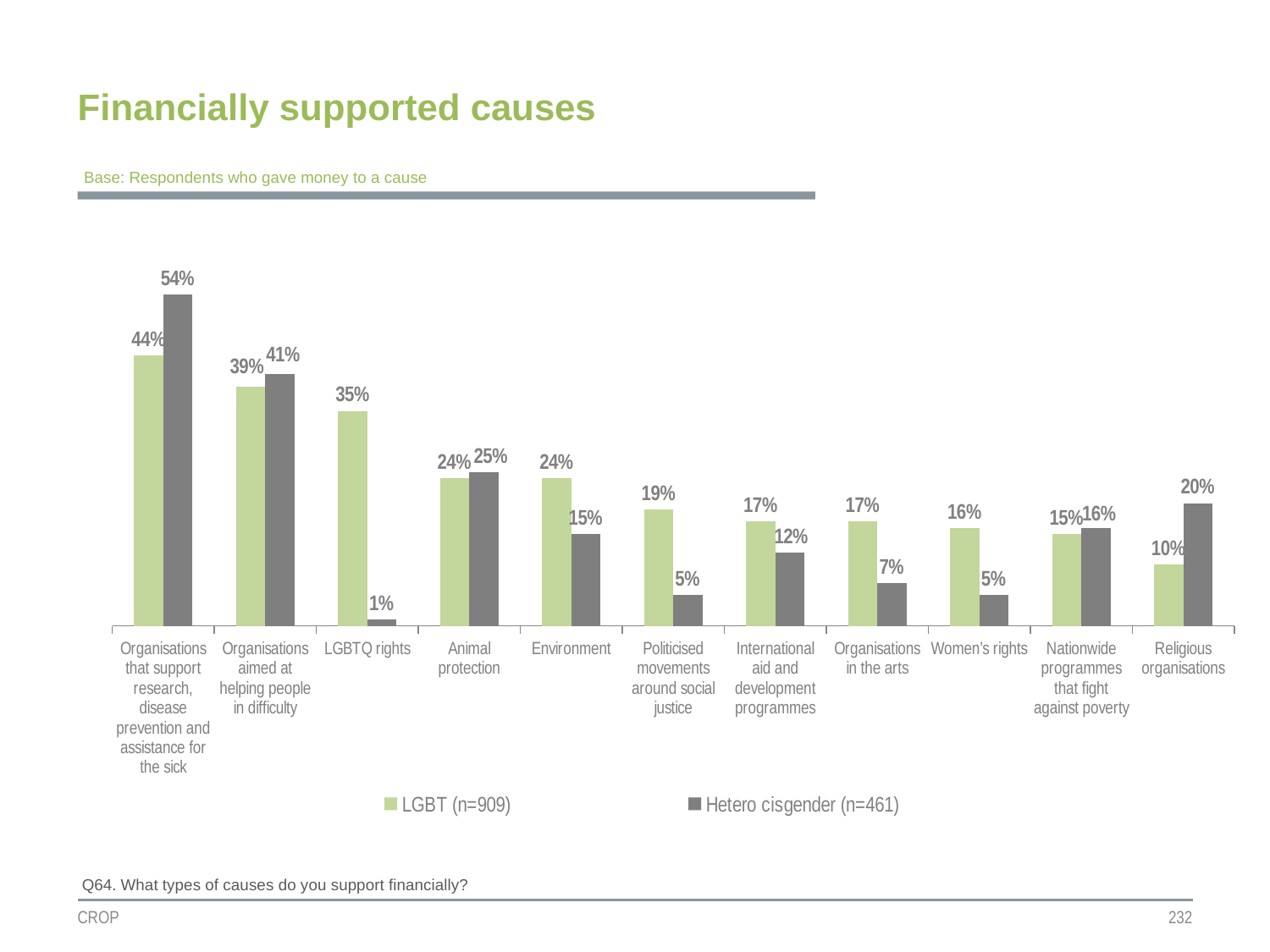
How many causes (categories) are shown on the x axis? 11 What is the difference between the Hetero cisgender and LGBT values for Organisations that support research, disease prevention and assistance for the sick? 10 percentage points What is the difference between the LGBT and Hetero cisgender values for LGBTQ rights? 34 percentage points How many series does the legend list? 2 What percentage of Hetero cisgender respondents financially supported Religious organisations? 20% What is the value for Hetero cisgender respondents for Politicised movements around social justice? 5% Which cause has the lowest value for LGBT respondents? Religious organisations Which cause has the highest value for Hetero cisgender respondents? Organisations that support research, disease prevention and assistance for the sick What percentage of LGBT respondents financially supported LGBTQ rights? 35% What type of chart is shown on the slide? Bar chart For Organisations in the arts, which group has the larger value, LGBT or Hetero cisgender? LGBT Which cause has the lowest value for Hetero cisgender respondents? LGBTQ rights